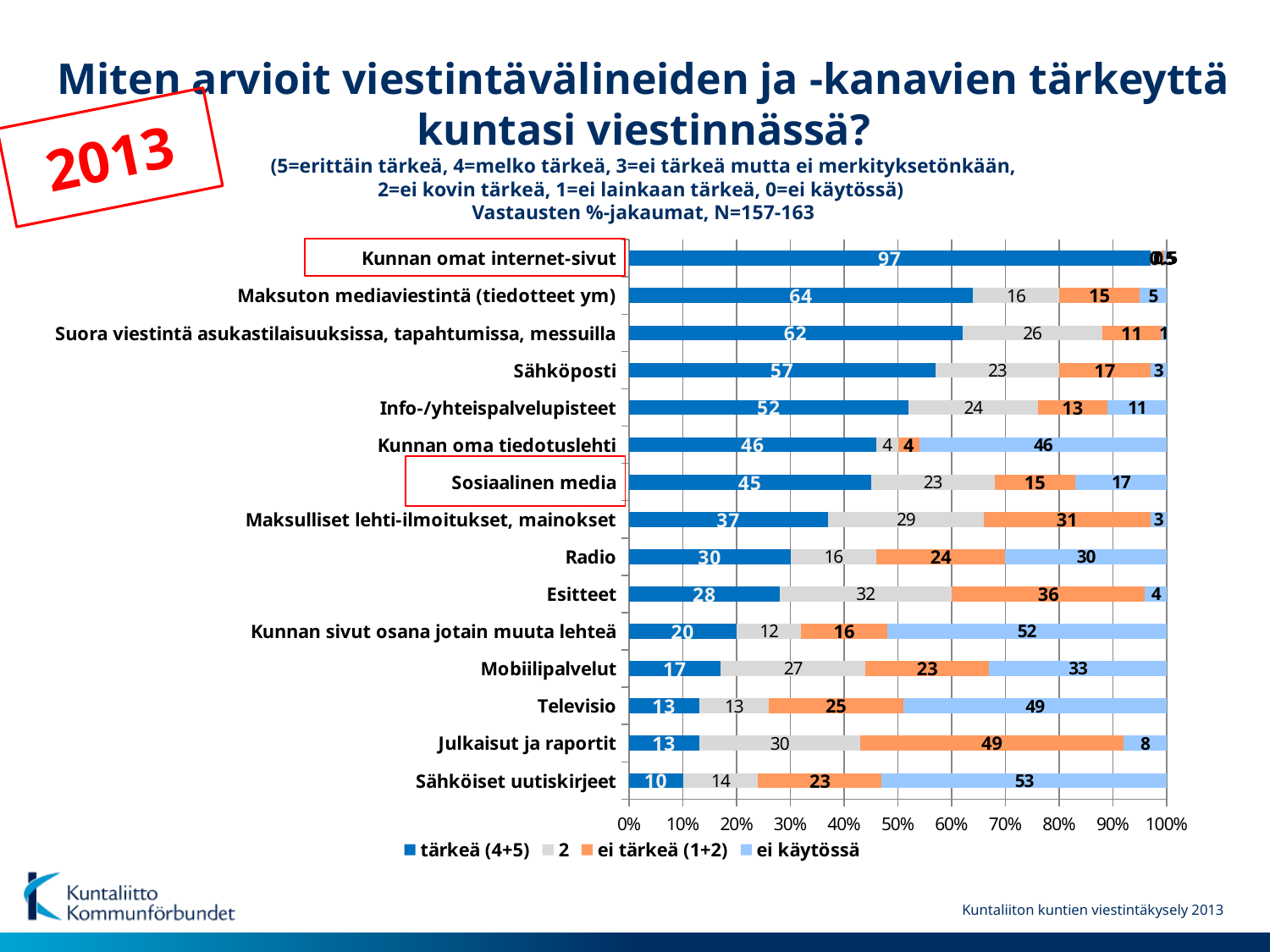
What is the difference between the 'tärkeä (4+5)' values for Maksuton mediaviestintä (tiedotteet ym) and Sosiaalinen media? 19 What kind of chart is shown on the slide? stacked bar chart How many series does the legend list? 4 What is the value of the '2' series for Esitteet? 32 Which category has the highest 'tärkeä (4+5)' value? Kunnan omat internet-sivut What is the total of the four segments for Radio? 100 Which category has the lowest 'tärkeä (4+5)' value? Sähköiset uutiskirjeet What is the 'ei käytössä' value for Sähköiset uutiskirjeet? 53 What is the 'tärkeä (4+5)' value for Sähköposti? 57 What is the 'ei tärkeä (1+2)' value for Julkaisut ja raportit? 49 Which has a larger 'ei käytössä' value, Televisio or Mobiilipalvelut? Televisio How many categories (communication channels) are plotted on the chart? 15